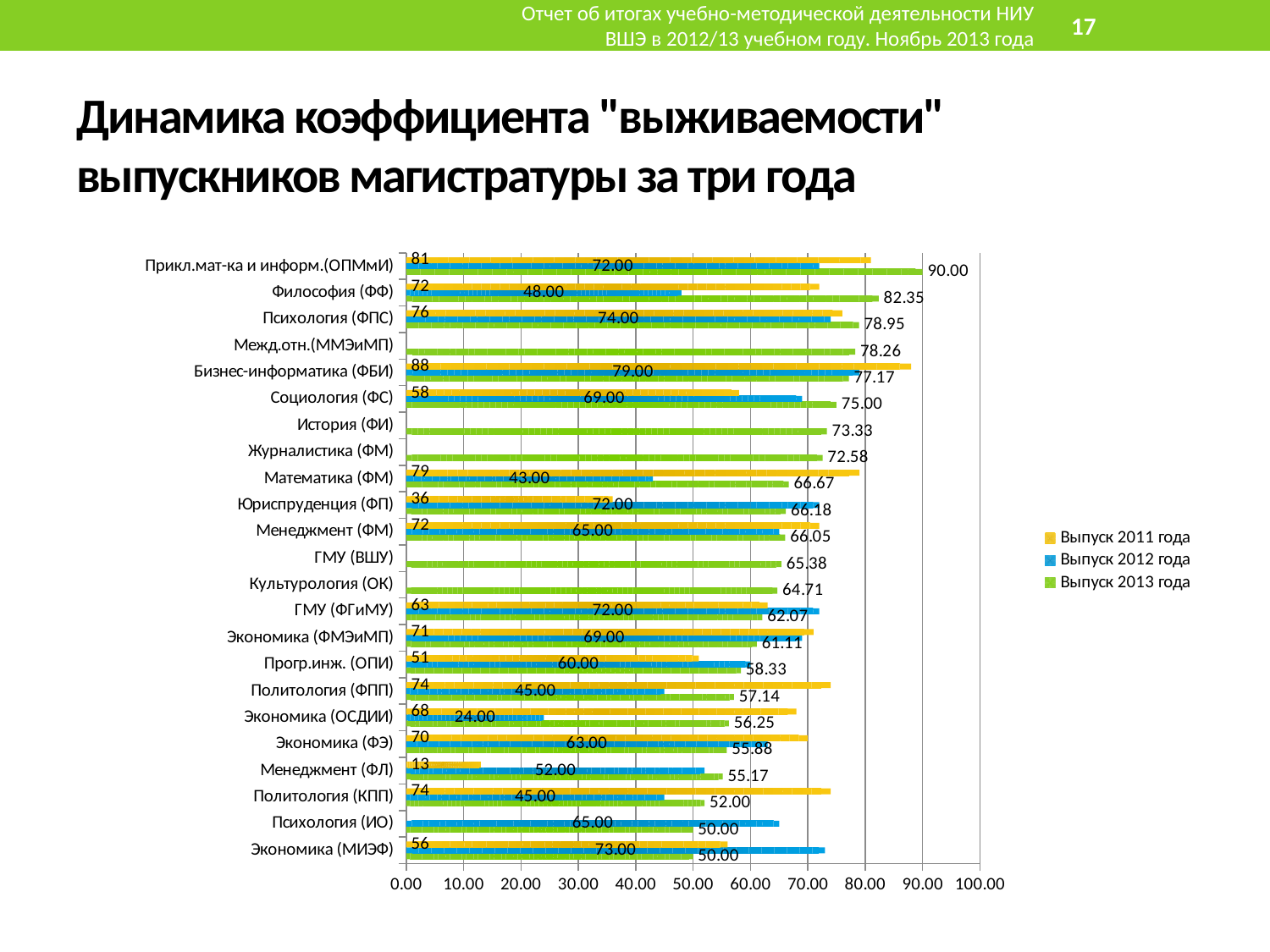
How many series does the legend list? 3 What is the value for Выпуск 2012 года for Философия (ФФ)? 48.00 What is the value for Выпуск 2012 года for Экономика (МИЭФ)? 73.00 For Экономика (ОСДИИ), which is larger: the Выпуск 2011 года value or the Выпуск 2012 года value? Выпуск 2011 года Which programme has the lowest value for Выпуск 2012 года? Экономика (ОСДИИ) What is the value for Выпуск 2011 года for Бизнес-информатика (ФБИ)? 88 What is the value for Выпуск 2013 года for Прикл.мат-ка и информ.(ОПМмИ)? 90.00 Which programme has the lowest value for Выпуск 2011 года? Менеджмент (ФЛ) What kind of chart is shown on the slide? bar chart Which programme has the highest value for Выпуск 2013 года? Прикл.мат-ка и информ.(ОПМмИ) How many programmes (categories) are listed on the vertical axis of the chart? 23 For Философия (ФФ), what is the difference between the Выпуск 2013 года value and the Выпуск 2012 года value? 34.35